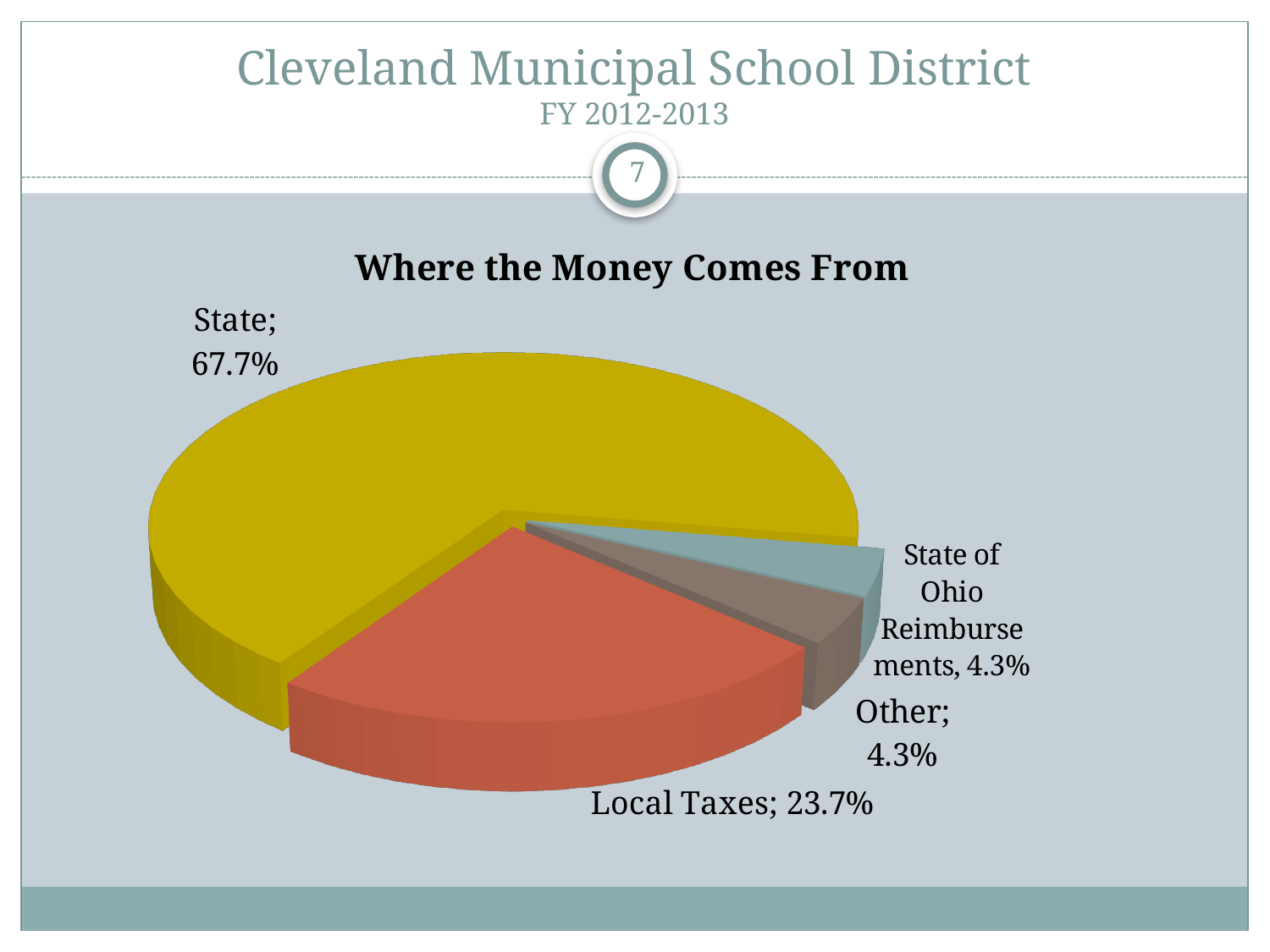
What share of the money comes from State of Ohio Reimbursements? 4.3% What kind of chart is shown on the slide? Pie chart What is the combined share of State of Ohio Reimbursements and Other? 8.6% What colour is the State slice of the pie? Yellow What share of the money comes from Other? 4.3% What share of the money comes from the State? 67.7% What is the title of the chart? Where the Money Comes From How many slices does the pie chart have? 4 Which source provides the largest share of the money? State Which is larger, the share from Local Taxes or the share from Other? Local Taxes What is the difference in percentage points between the State share and the Local Taxes share? 44.0 percentage points What share of the money comes from Local Taxes? 23.7%